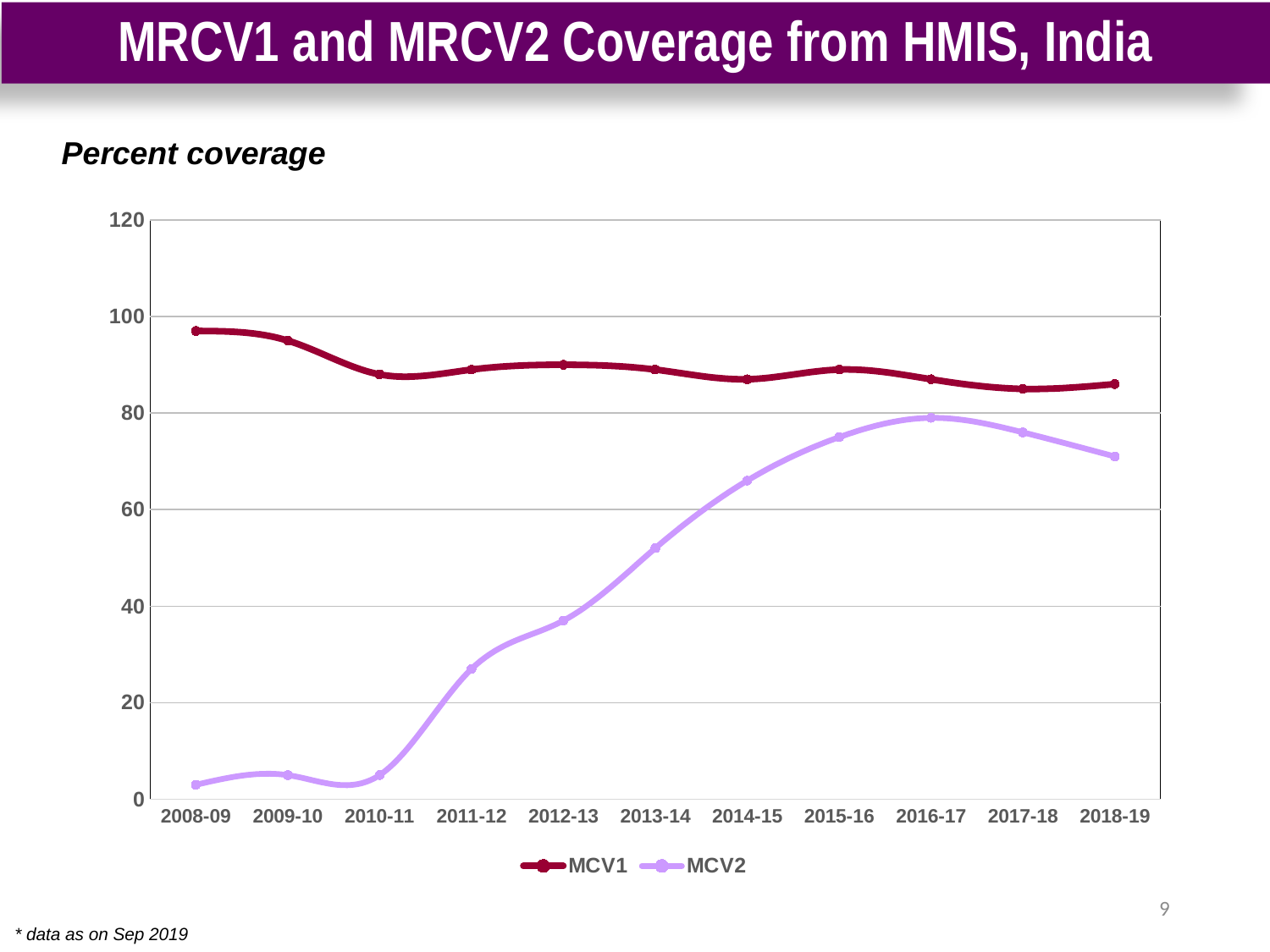
Is the MCV2 value for 2008-09 greater or less than 20? less What kind of chart is shown on the slide? Line chart Is the MCV1 value for 2008-09 greater or less than 100? less How many series does the legend list? 2 Does MCV2 coverage rise or fall from 2008-09 to 2016-17? Rise Is the MCV2 value for 2013-14 greater or less than 40? greater Which year has the highest MCV2 coverage? 2016-17 Does MCV1 coverage rise or fall from 2008-09 to 2018-19? Fall How many year categories are shown on the x axis? 11 In 2012-13, which series has the higher value, MCV1 or MCV2? MCV1 What colour is the MCV2 line in the chart? Light purple